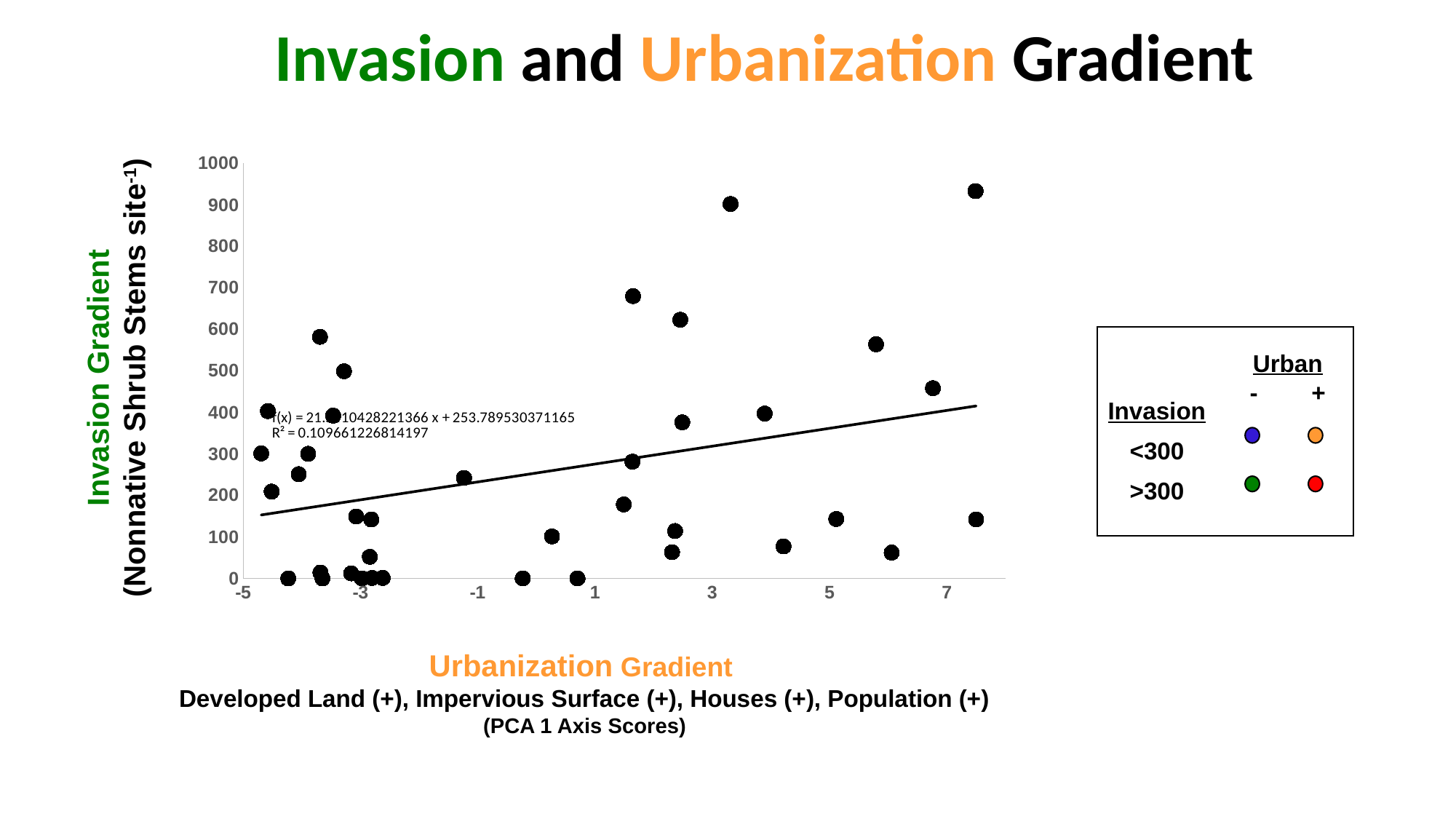
Is the value of the point near x = 5.8 that lies above the trend line greater or less than 500? greater What is the highest tick value shown on the y axis? 1000 Is the value of the point near x = 1.6 that lies well above the trend line greater or less than 600? greater What is the title of the slide's chart? Invasion and Urbanization Gradient Does the fitted trend line rise or fall as the Urbanization Gradient increases? Rises Is the value of the highest point on the chart (near x = 7.5) greater or less than 800? greater What is the lowest tick value shown on the x axis? -5 What kind of chart is shown on the slide? Scatter plot What is the y-intercept of the fitted line f(x) printed on the chart? 253.789530371165 What R² value is printed on the chart? 0.109661226814197